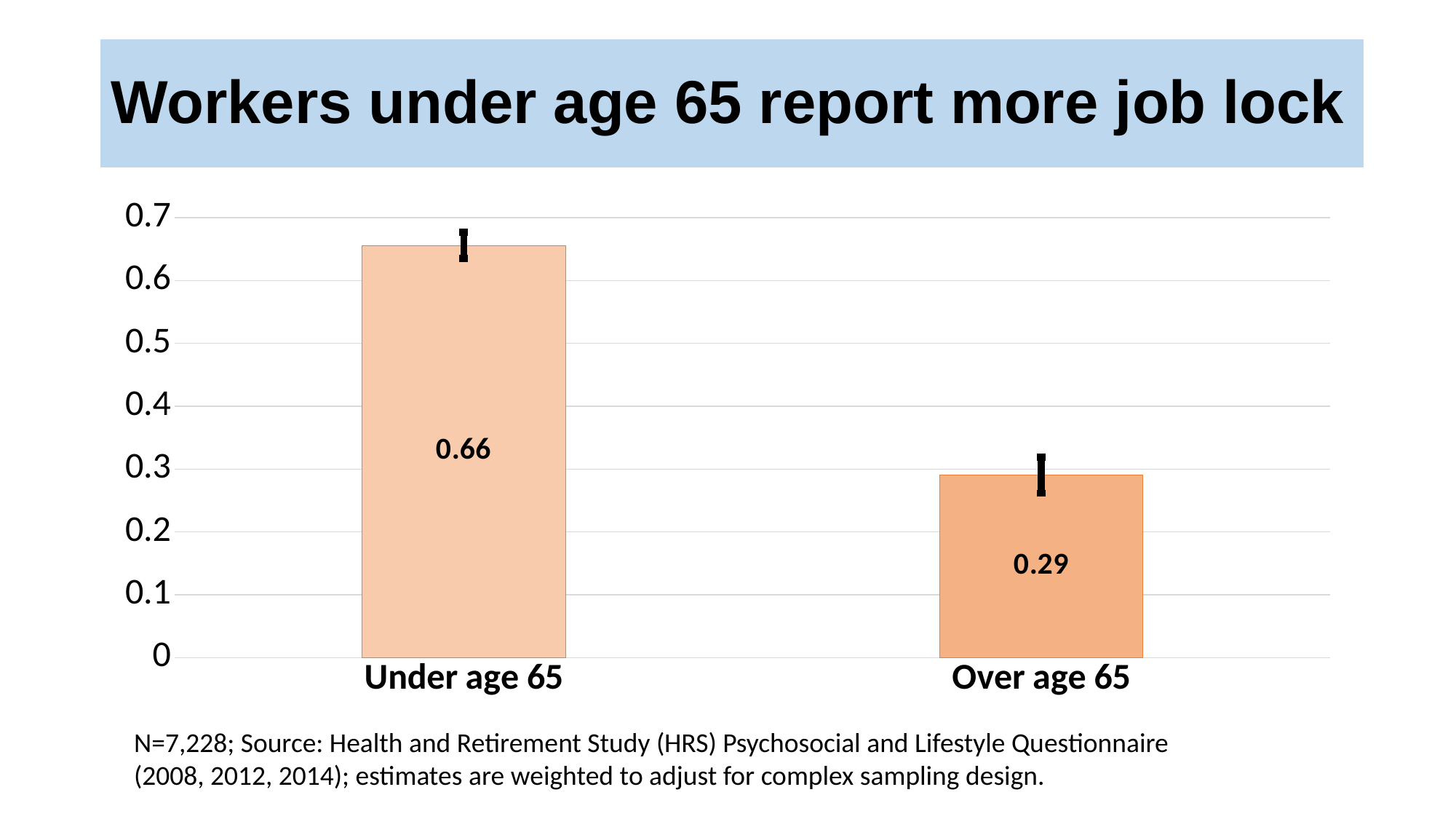
What is the value for Under age 65? 0.66 What is the title of the slide? Workers under age 65 report more job lock What is the value for Over age 65? 0.29 Which category has the lowest value? Over age 65 What kind of chart is shown on the slide? Bar chart Is the value for Under age 65 greater or less than 0.6? greater What is the sample size (N) stated in the note below the chart? 7,228 Is the value for Over age 65 greater or less than 0.3? less How many categories are shown on the x axis? 2 Which category has the highest value? Under age 65 What is the difference between the values for Under age 65 and Over age 65? 0.37 Which is larger, the value for Under age 65 or the value for Over age 65? Under age 65